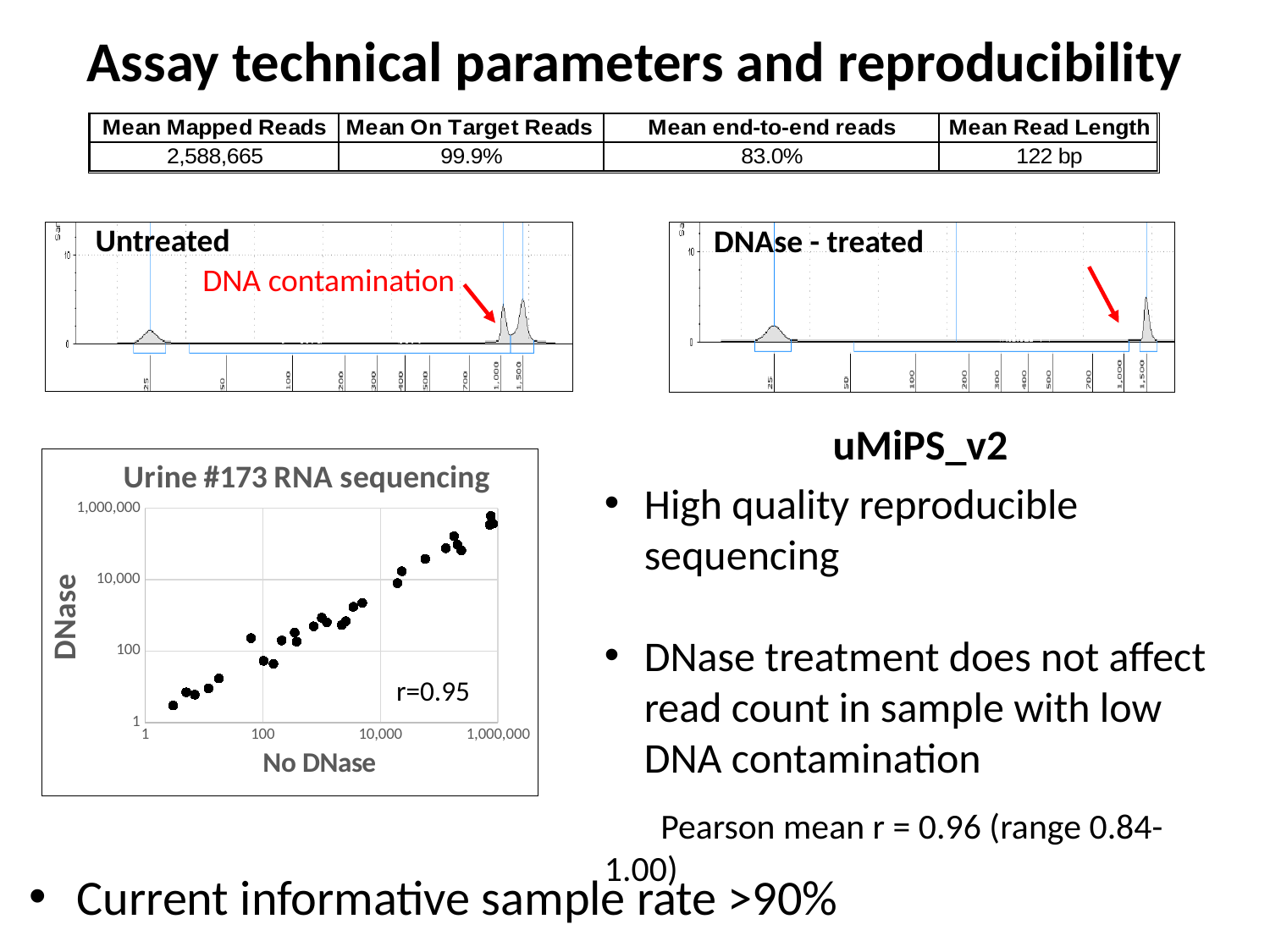
In the 'Urine #173 RNA sequencing' chart, what is the label of the x axis? No DNase In the 'Urine #173 RNA sequencing' chart, is the No DNase value of the lowest point greater or less than 100? less What is the title of the scatter chart on the lower left of the slide? Urine #173 RNA sequencing In the 'Urine #173 RNA sequencing' chart, is the DNase value of the lowest point greater or less than 100? less In the 'Urine #173 RNA sequencing' chart, what is the highest tick value shown on the y axis? 1,000,000 In the 'Urine #173 RNA sequencing' chart, do the DNase values rise or fall as the No DNase values increase along the x axis? rise In the 'Urine #173 RNA sequencing' chart, what is the lowest tick value shown on the x axis? 1 Which of the two electropherogram panels at the top of the slide is annotated with 'DNA contamination'? Untreated What kind of chart is the 'Urine #173 RNA sequencing' chart? scatter chart What correlation coefficient is printed on the 'Urine #173 RNA sequencing' chart? r=0.95 In the 'Urine #173 RNA sequencing' chart, is the DNase value of the highest point greater or less than 10,000? greater